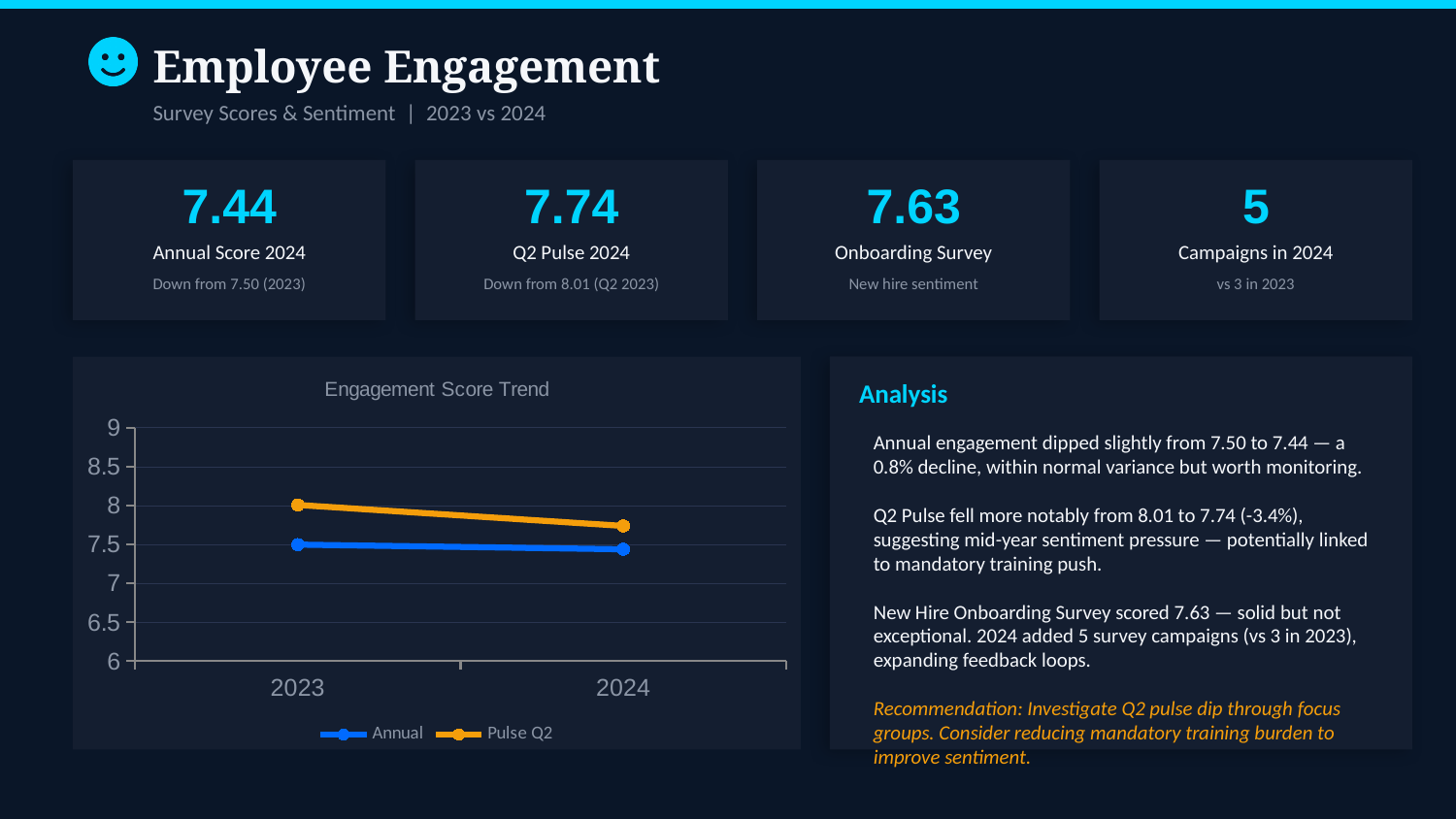
How many years are shown on the x axis of the Engagement Score Trend chart? 2 What kind of chart is the Engagement Score Trend chart? line chart In the Engagement Score Trend chart, which series is higher in 2024, Annual or Pulse Q2? Pulse Q2 What colour is the Annual line in the Engagement Score Trend chart? blue How many series does the legend of the Engagement Score Trend chart list? 2 What are the two series named in the legend of the Engagement Score Trend chart? Annual and Pulse Q2 In the Engagement Score Trend chart, which series is higher in 2023, Annual or Pulse Q2? Pulse Q2 In the Engagement Score Trend chart, is the Annual value for 2024 greater or less than 7? greater In the Engagement Score Trend chart, does the Annual line rise or fall from 2023 to 2024? fall In the Engagement Score Trend chart, is the Pulse Q2 value for 2024 greater or less than 8? less In the Engagement Score Trend chart, is the Pulse Q2 value for 2024 greater or less than 7.5? greater In the Engagement Score Trend chart, does the Pulse Q2 line rise or fall from 2023 to 2024? fall